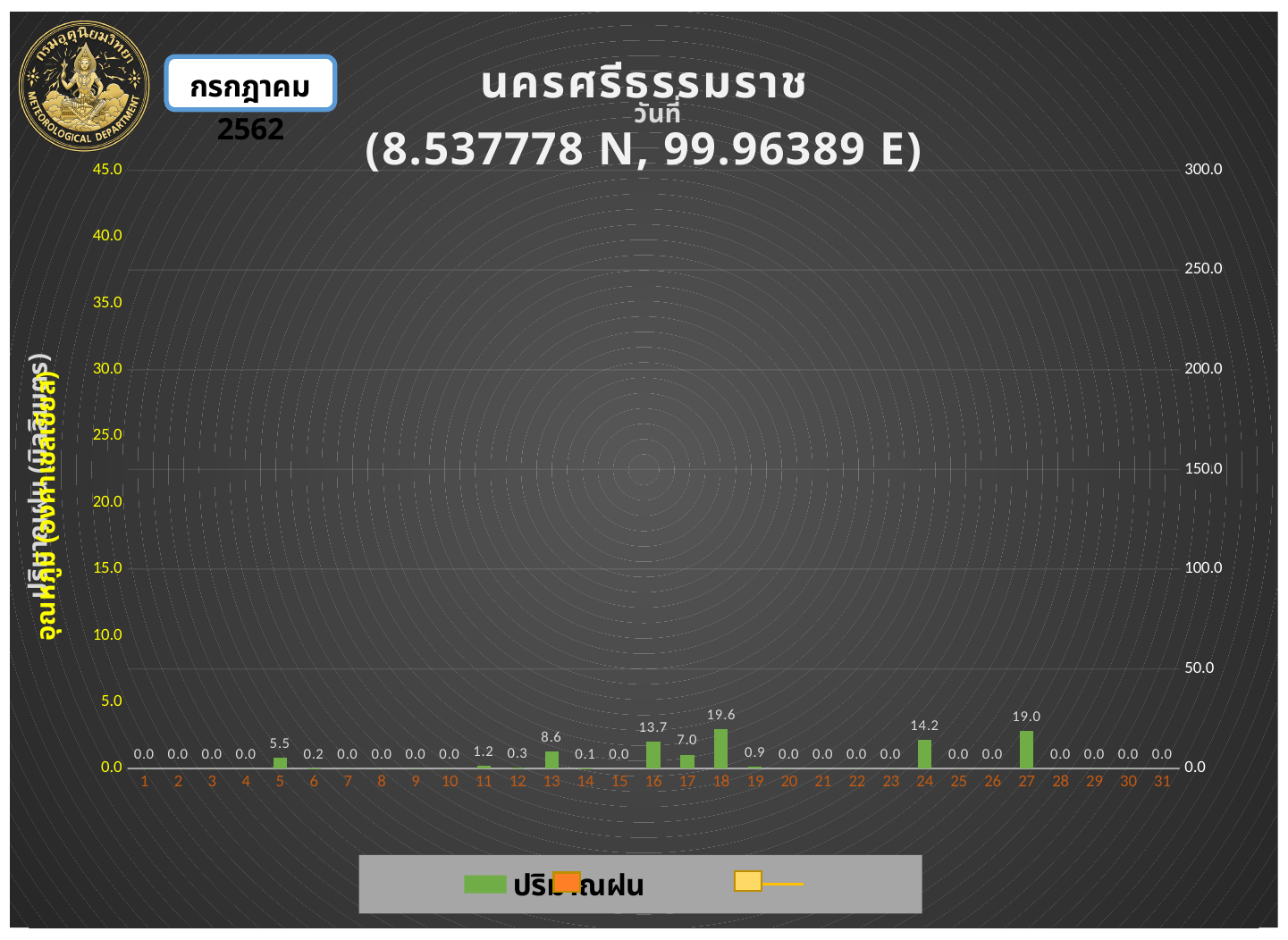
What is the difference between the rainfall values for day 18 and day 27? 0.6 Which day has the highest rainfall value? 18 What kind of chart is shown on the slide? bar chart What is the rainfall value shown for day 16? 13.7 What is the rainfall value shown for day 18? 19.6 What is the rainfall value shown for day 5? 5.5 What is the rainfall value shown for day 27? 19.0 What colour are the rainfall bars in the chart? green Which is larger, the rainfall value for day 13 or for day 24? day 24 How many days are shown on the x axis? 31 What is the difference between the rainfall values for day 16 and day 17? 6.7